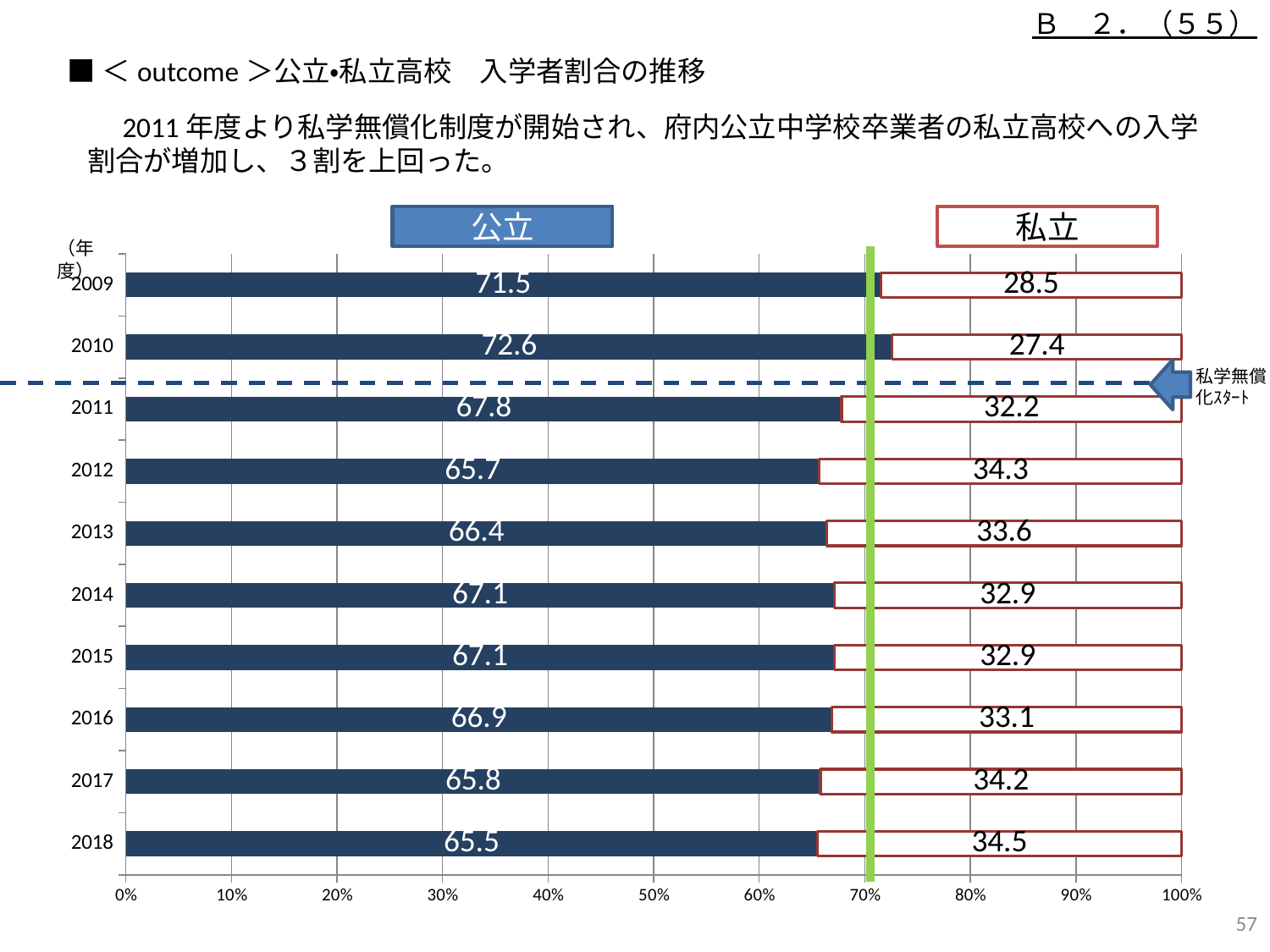
What kind of chart is shown on the slide? Stacked bar chart Which year has the highest 公立 value? 2010 How many series does the chart show? 2 What is the 私立 value for 2011? 32.2 How many years are shown on the chart? 10 Which year has the lowest 私立 value? 2010 Which is larger, the 私立 value for 2012 or the 私立 value for 2013? 2012 What is the total of the 公立 and 私立 values for 2017? 100 Does the 私立 value rise or fall from 2010 to 2012? Rise What is the 公立 value for 2009? 71.5 What is the difference between the 公立 values for 2010 and 2011? 4.8 What is the 私立 value for 2018? 34.5